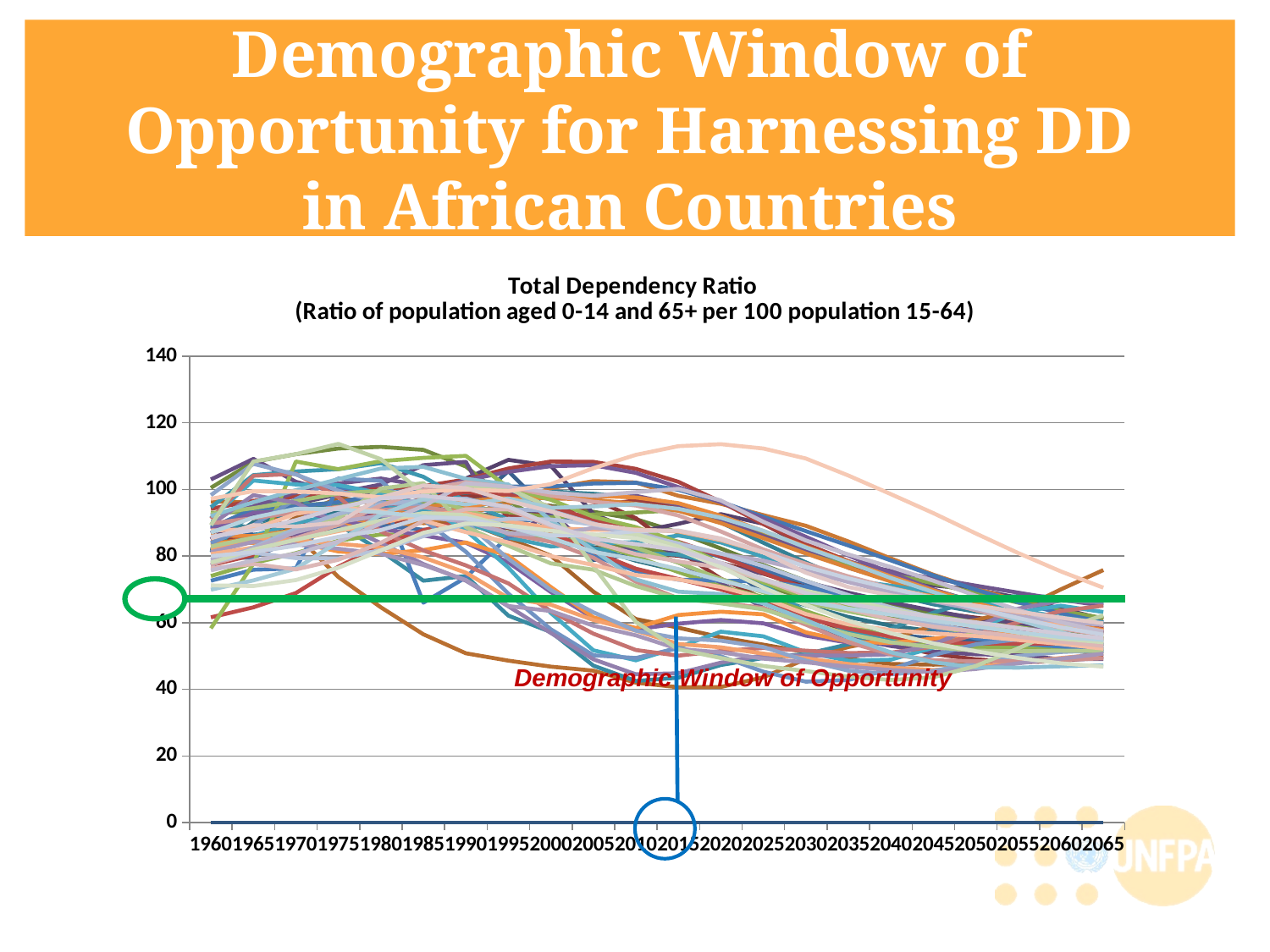
What is the first year shown on the x axis of the chart? 1960 What text is written in red italics inside the plot area? Demographic Window of Opportunity What kind of chart is shown on the slide? Line chart Which year on the x axis is circled in blue below the chart? 2015 Is the highest point reached by any line on the chart greater or less than 120? less What is the interval between consecutive year labels on the x axis? 5 years How many year points are labelled along the x axis of the chart? 22 Is the green horizontal line on the chart drawn above or below the 80 gridline? below What is the last year shown on the x axis of the chart? 2065 What is the title of the chart? Total Dependency Ratio (Ratio of population aged 0-14 and 65+ per 100 population 15-64) What is the highest value labelled on the y axis of the chart? 140 Do the plotted lines generally rise or fall between 2020 and 2065? Fall